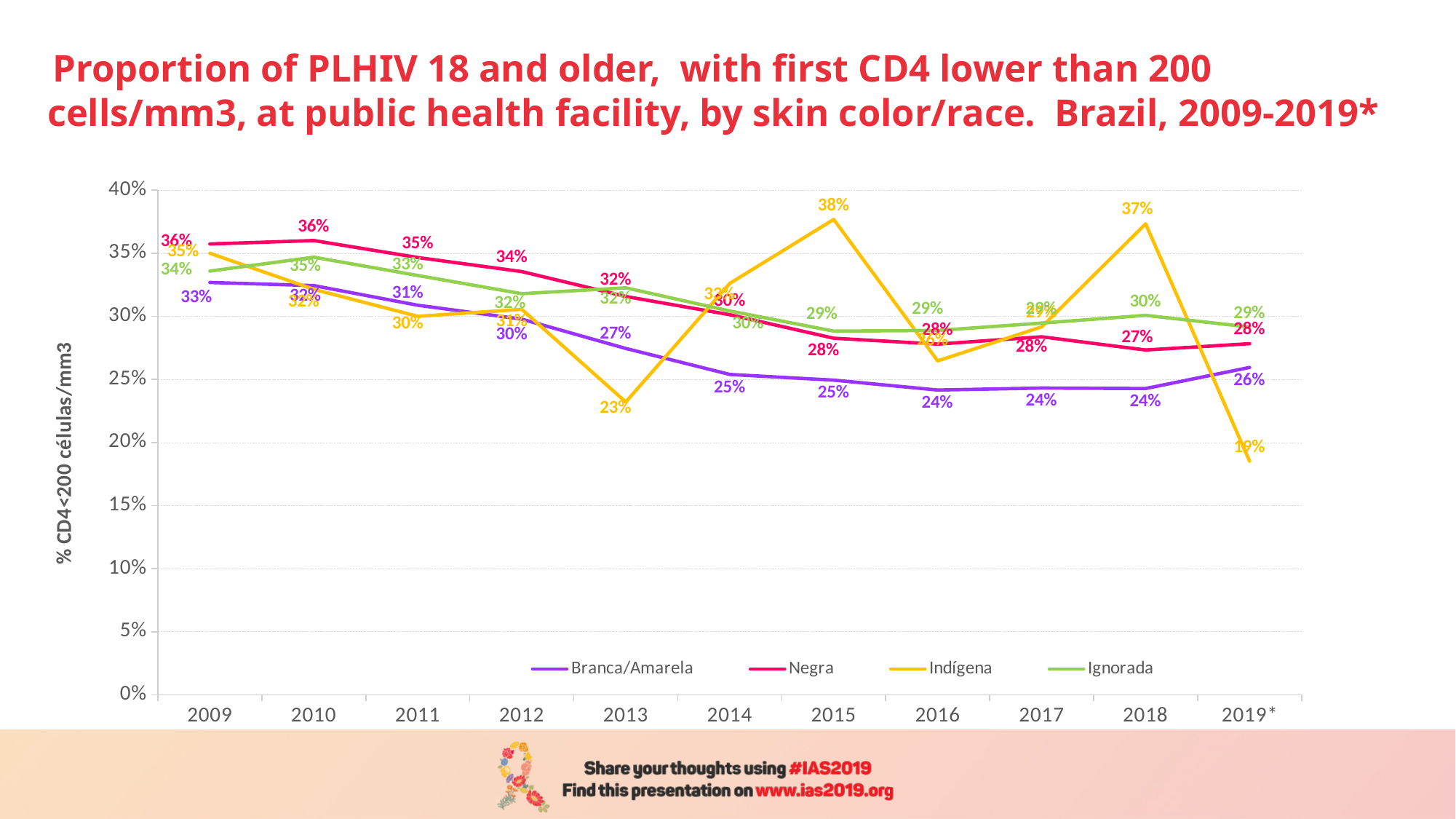
In which year does the Indígena series reach its highest value? 2015 What is the value for Indígena in 2015? 38% What is the difference between the Negra value in 2009 and the Negra value in 2018? 9% What is the value for Branca/Amarela in 2013? 27% Which series has the higher value in 2013, Branca/Amarela or Indígena? Branca/Amarela Does the Negra series rise or fall from 2009 to 2018? fall What is the value for Negra in 2009? 36% In which year does the Indígena series reach its lowest value? 2019* How many years are shown on the x axis? 11 What is the value for Indígena in 2019*? 19% What kind of chart is shown on the slide? line chart How many series does the legend list? 4